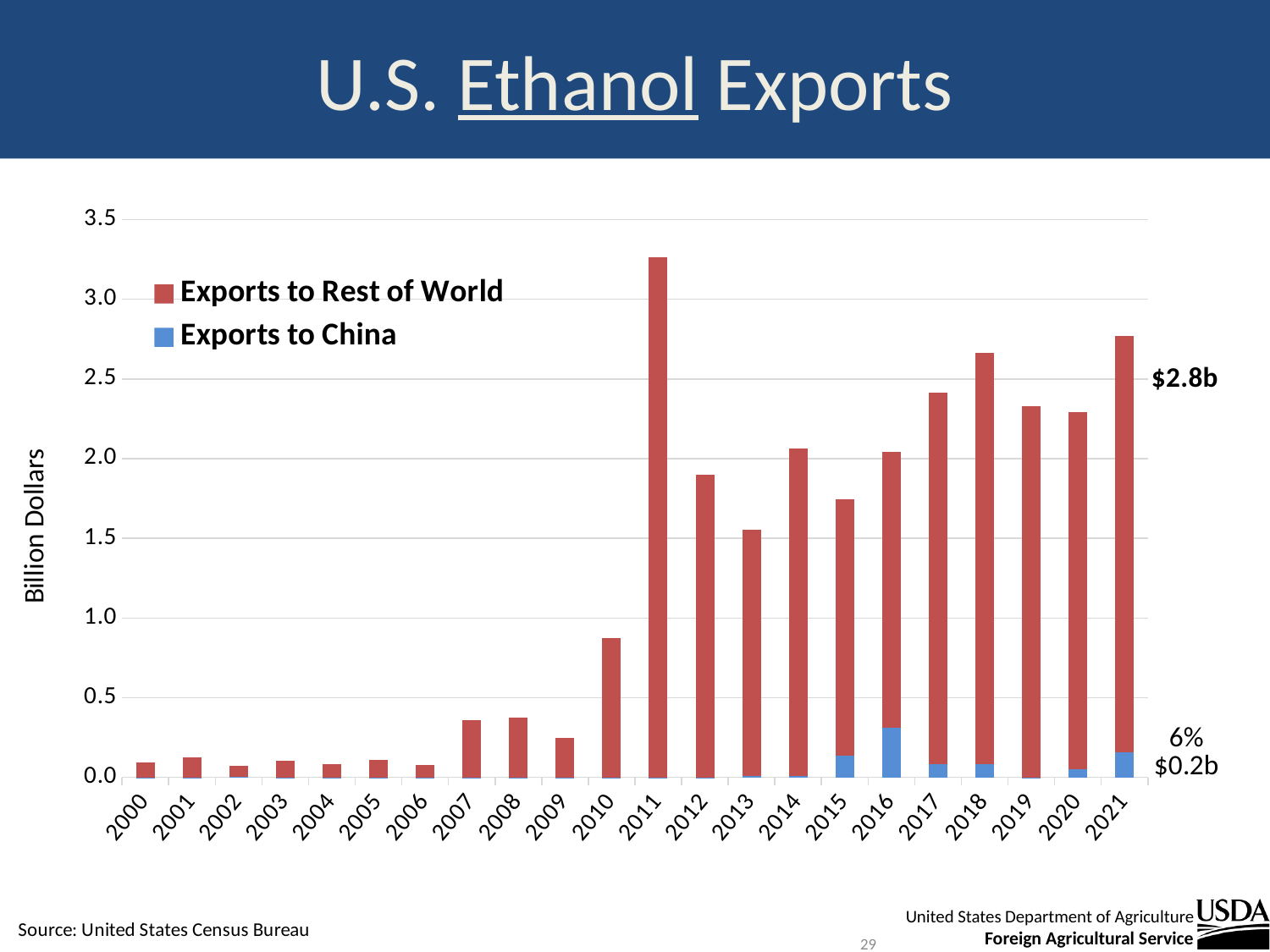
Which year shows the largest Exports to China bar? 2016 What is the label on the y axis? Billion Dollars How many years are shown on the x axis? 22 What share of 2021 ethanol exports went to China, according to the label? 6% How many series does the legend list? 2 What value is labeled for Exports to China in 2021? $0.2b Which year has the highest total ethanol exports? 2011 What total value is labeled for 2021? $2.8b Is the total value for 2010 greater or less than 1.0? less Is the total value for 2011 greater or less than 3.0? greater Which year has larger total exports, 2018 or 2019? 2018 What kind of chart is shown on the slide? Bar chart